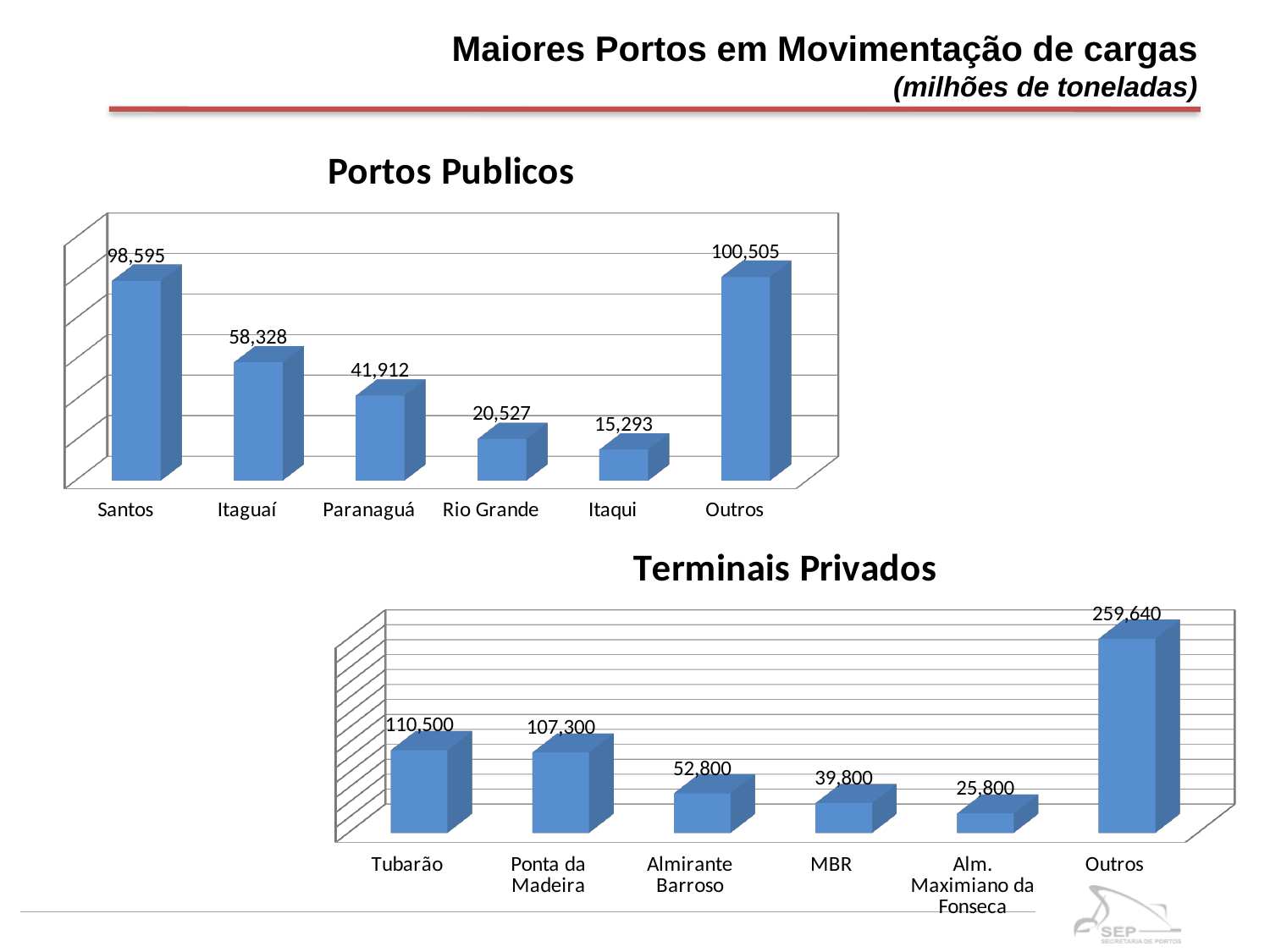
In the Terminais Privados chart, which is larger, Almirante Barroso or MBR? Almirante Barroso What kind of chart is the Terminais Privados chart? Bar chart In the Terminais Privados chart, which category has the highest value? Outros In the Terminais Privados chart, what is the value for Alm. Maximiano da Fonseca? 25,800 In the Portos Publicos chart, what is the value for Rio Grande? 20,527 In the Portos Publicos chart, what is the value for Santos? 98,595 In the Terminais Privados chart, what is the value for Ponta da Madeira? 107,300 In the Portos Publicos chart, how many categories are shown? 6 In the Portos Publicos chart, which category has the highest value? Outros In the Terminais Privados chart, what is the difference between Outros and Tubarão? 149,140 In the Portos Publicos chart, what is the difference between Santos and Itaguaí? 40,267 In the Portos Publicos chart, which category has the lowest value? Itaqui